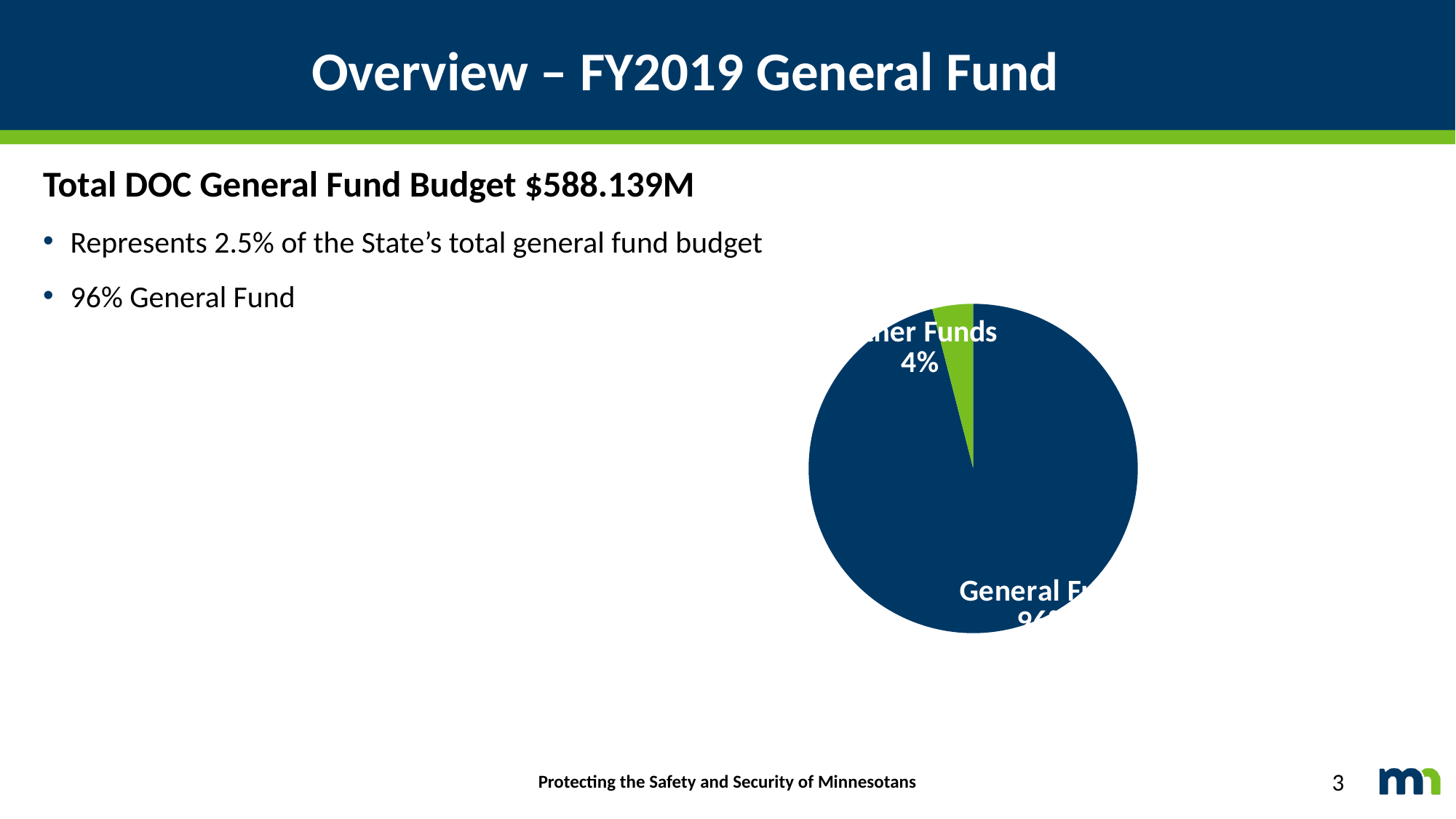
What kind of chart is shown on the slide? pie chart Which slice of the pie chart is the smallest? Other Funds How many slices does the pie chart have? 2 What share of the pie is General Fund? 96% What is the difference in percentage points between the General Fund and Other Funds slices? 92 Which slice of the pie chart is the largest? General Fund What share of the pie is Other Funds? 4% What colour is the General Fund slice in the pie chart? dark blue Which is larger in the pie chart, General Fund or Other Funds? General Fund What colour is the Other Funds slice in the pie chart? green